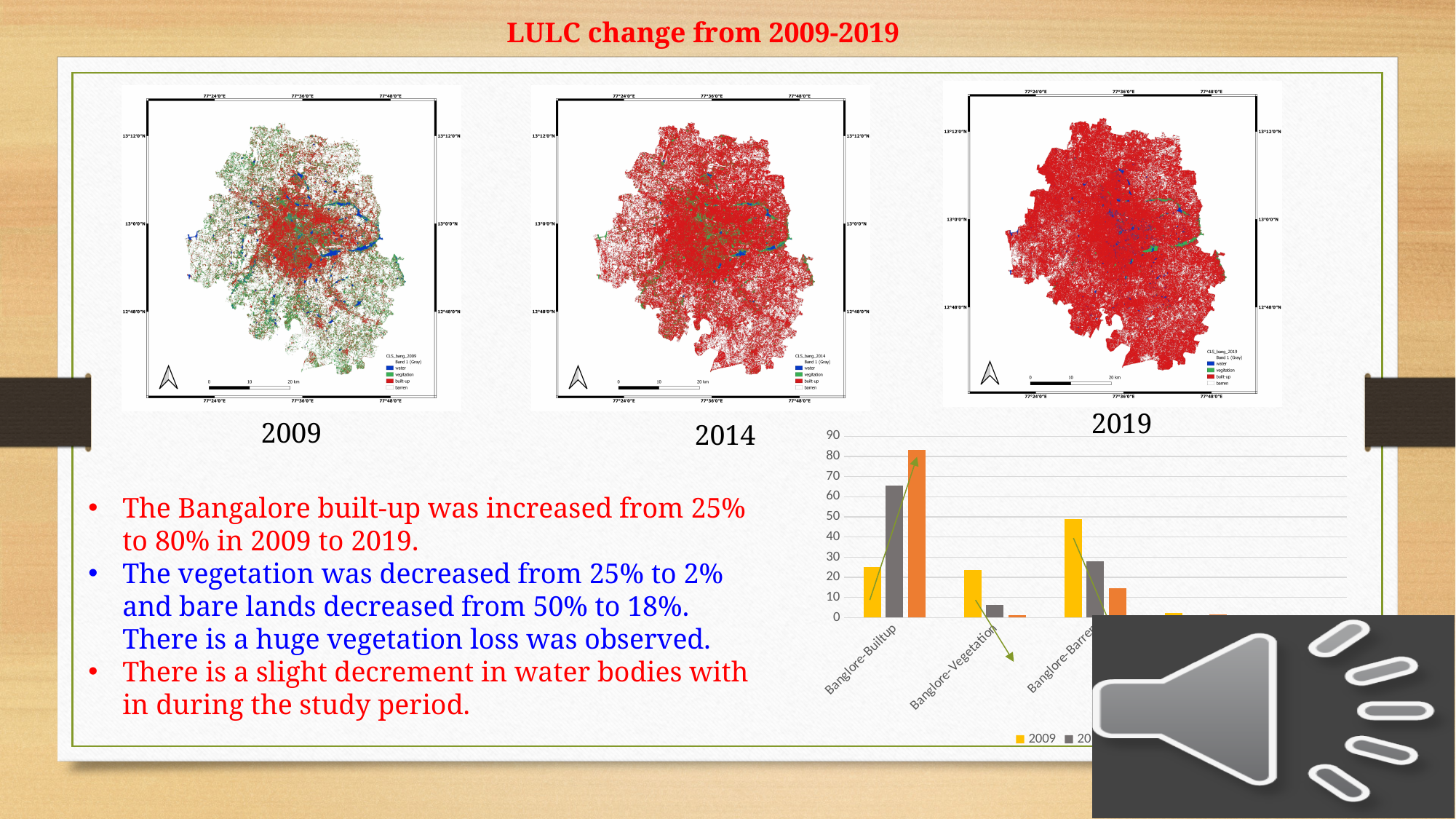
In the bar chart, which category has the tallest bar overall? Banglore-Builtup In the bar chart, is the orange bar for Banglore-Builtup greater or less than 70? greater In the bar chart, is the gray bar for Banglore-Vegetation greater or less than 10? less In the bar chart, do the bars for Banglore-Vegetation rise or fall from the yellow bar to the orange bar? fall In the bar chart, is the gray bar for Banglore-Builtup greater or less than 60? greater In the bar chart, which is larger for Banglore-Vegetation: the 2009 bar or the orange bar? the 2009 bar What kind of chart is shown at the bottom right of the slide? bar chart In the bar chart, how many bars are shown for the Banglore-Builtup category? 3 In the bar chart, which is larger for Banglore-Builtup: the 2009 bar or the orange bar? the orange bar